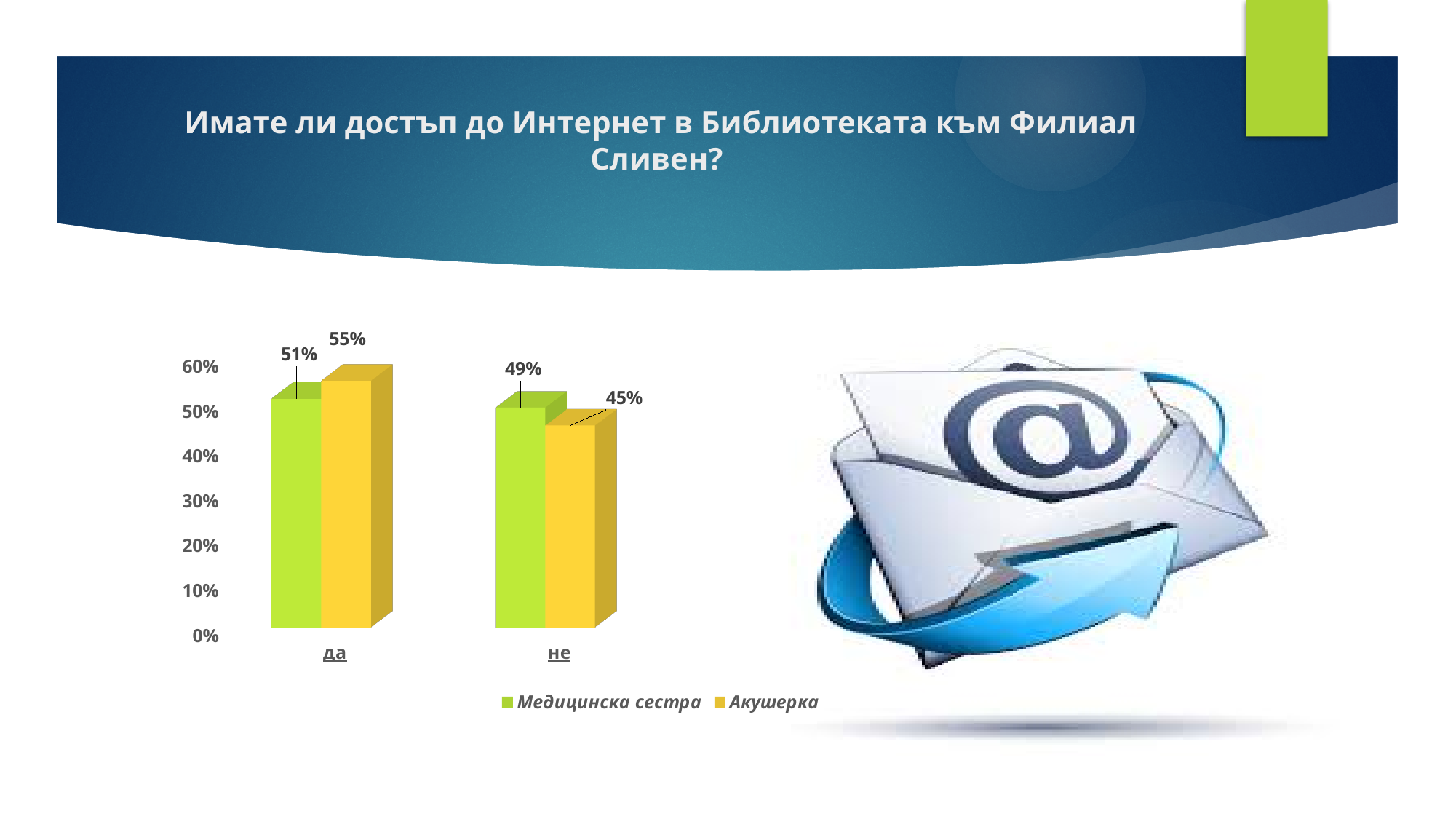
What is the difference between the Медицинска сестра and Акушерка values in the не category? 4% How many series does the legend list? 2 What kind of chart is shown on the slide? Bar chart What is the difference between the Акушерка and Медицинска сестра values in the да category? 4% Which colour represents the Акушерка series? Yellow Which series has the higher value in the да category? Акушерка What is the value for Акушерка in the да category? 55% What is the value for Медицинска сестра in the не category? 49% What is the value for Акушерка in the не category? 45% What is the value for Медицинска сестра in the да category? 51% Which series has the higher value in the не category? Медицинска сестра How many categories are shown on the x axis? 2